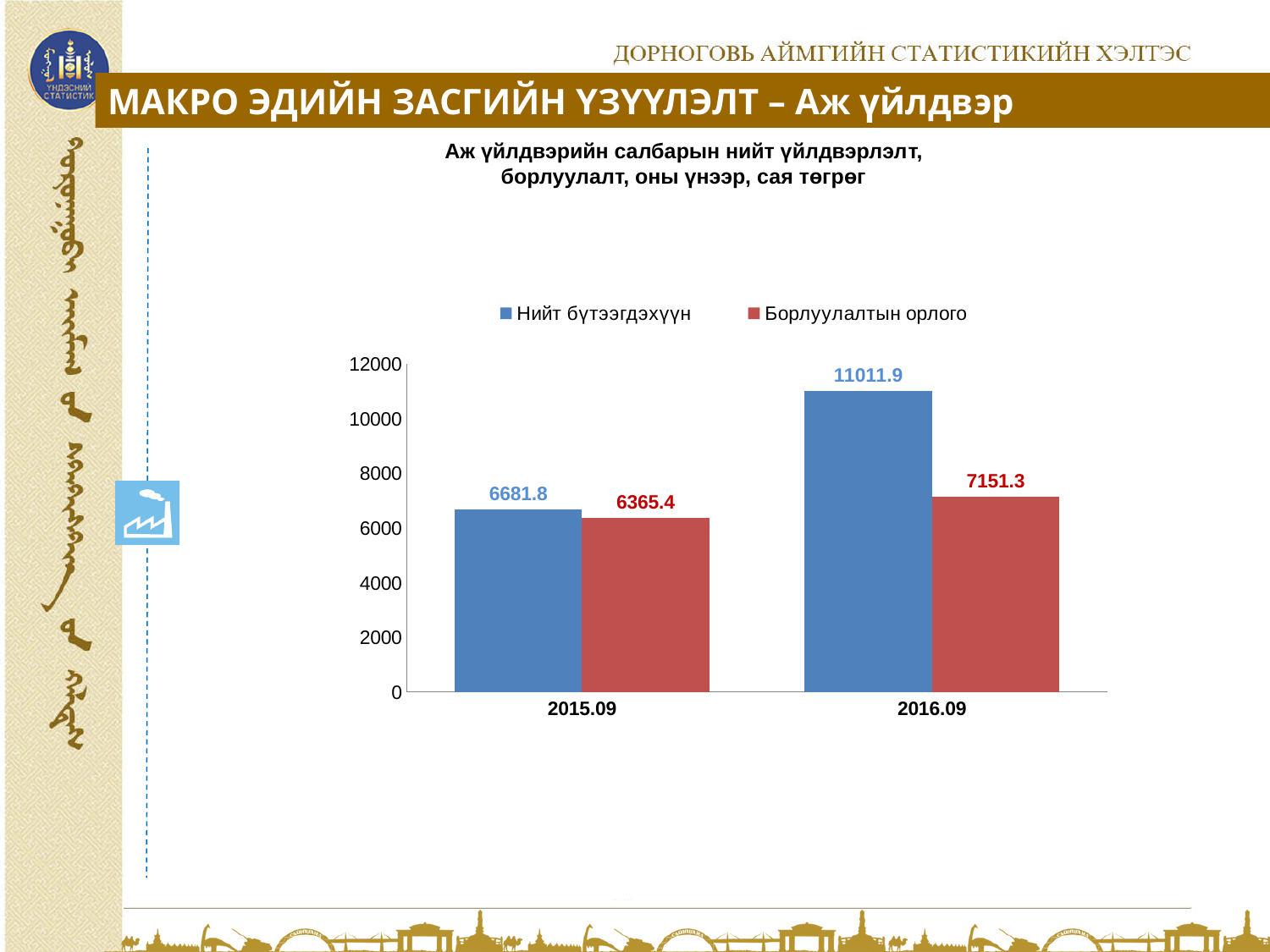
In 2015.09, which is larger: Нийт бүтээгдэхүүн or Борлуулалтын орлого? Нийт бүтээгдэхүүн How many series does the legend list? 2 What kind of chart is shown on the slide? bar chart Which period has the highest value for Нийт бүтээгдэхүүн? 2016.09 Which period has the lowest value for Борлуулалтын орлого? 2015.09 What is the value of Борлуулалтын орлого for 2016.09? 7151.3 How many periods are shown on the x axis? 2 What is the value of Нийт бүтээгдэхүүн for 2015.09? 6681.8 What is the value of Борлуулалтын орлого for 2015.09? 6365.4 What is the difference between Нийт бүтээгдэхүүн in 2016.09 and in 2015.09? 4330.1 What is the difference between Нийт бүтээгдэхүүн and Борлуулалтын орлого in 2016.09? 3860.6 Is the value of Нийт бүтээгдэхүүн for 2016.09 greater or less than 10000? greater